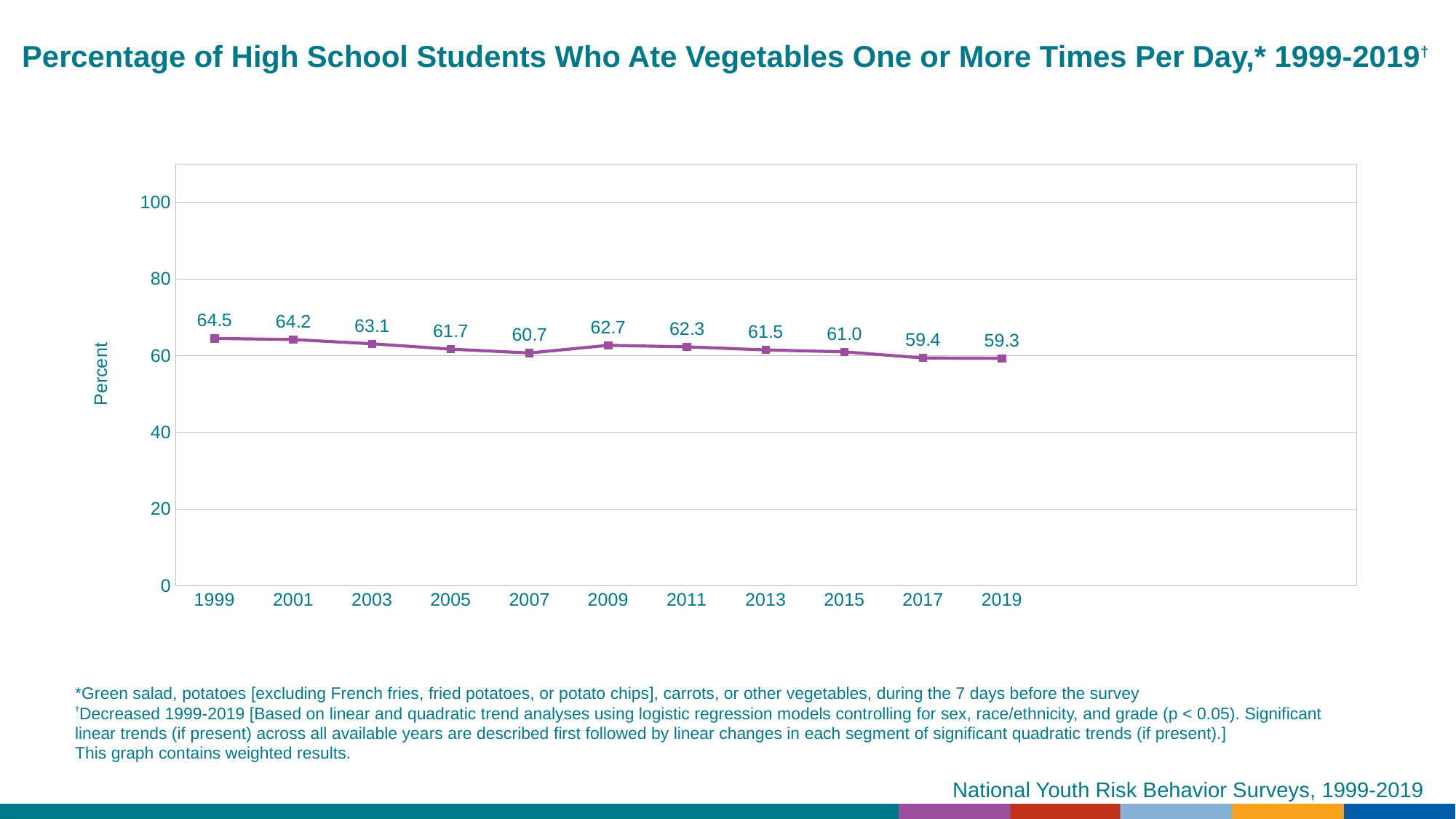
What kind of chart is shown on the slide? line chart Is the value for 2013 greater or less than 80? less Which year has the highest value on the chart? 1999 How many years are plotted on the x axis? 11 Which year has the lowest value on the chart? 2019 What is the value plotted for 2019? 59.3 What is the label on the y axis? Percent Do the values generally rise or fall from 1999 to 2019? fall What is the value plotted for 2009? 62.7 Which is larger, the value for 2007 or the value for 2009? 2009 What is the difference between the 1999 value and the 2019 value? 5.2 What percentage of high school students ate vegetables one or more times per day in 1999? 64.5